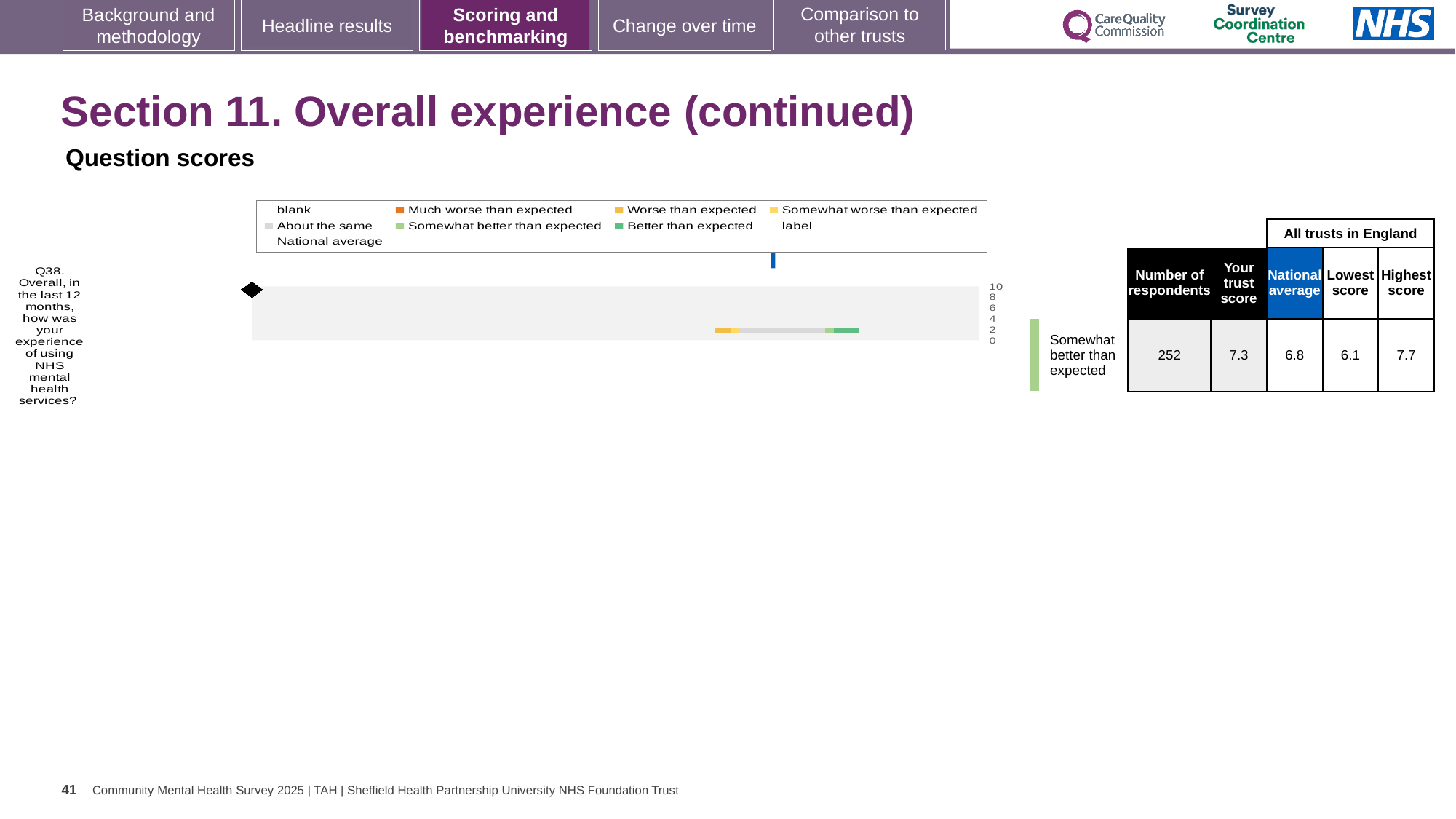
Which benchmarking category is the trust's Q38 result placed in? Somewhat better than expected What is the national average score for Q38 shown in the table? 6.8 Which is larger for Q38, the trust's score or the national average? Your trust score How many respondents answered Q38? 252 What is the difference between the highest and lowest scores among all trusts in England for Q38? 1.6 How many questions are plotted on the chart? 1 What is the difference between the trust's score and the national average for Q38? 0.5 What is the trust's score for Q38 shown in the table next to the chart? 7.3 Which legend entry is shown in orange? Much worse than expected What kind of chart is used to show the Q38 benchmarking result? Bar chart What is the lowest score among all trusts in England for Q38? 6.1 What is the highest score among all trusts in England for Q38? 7.7